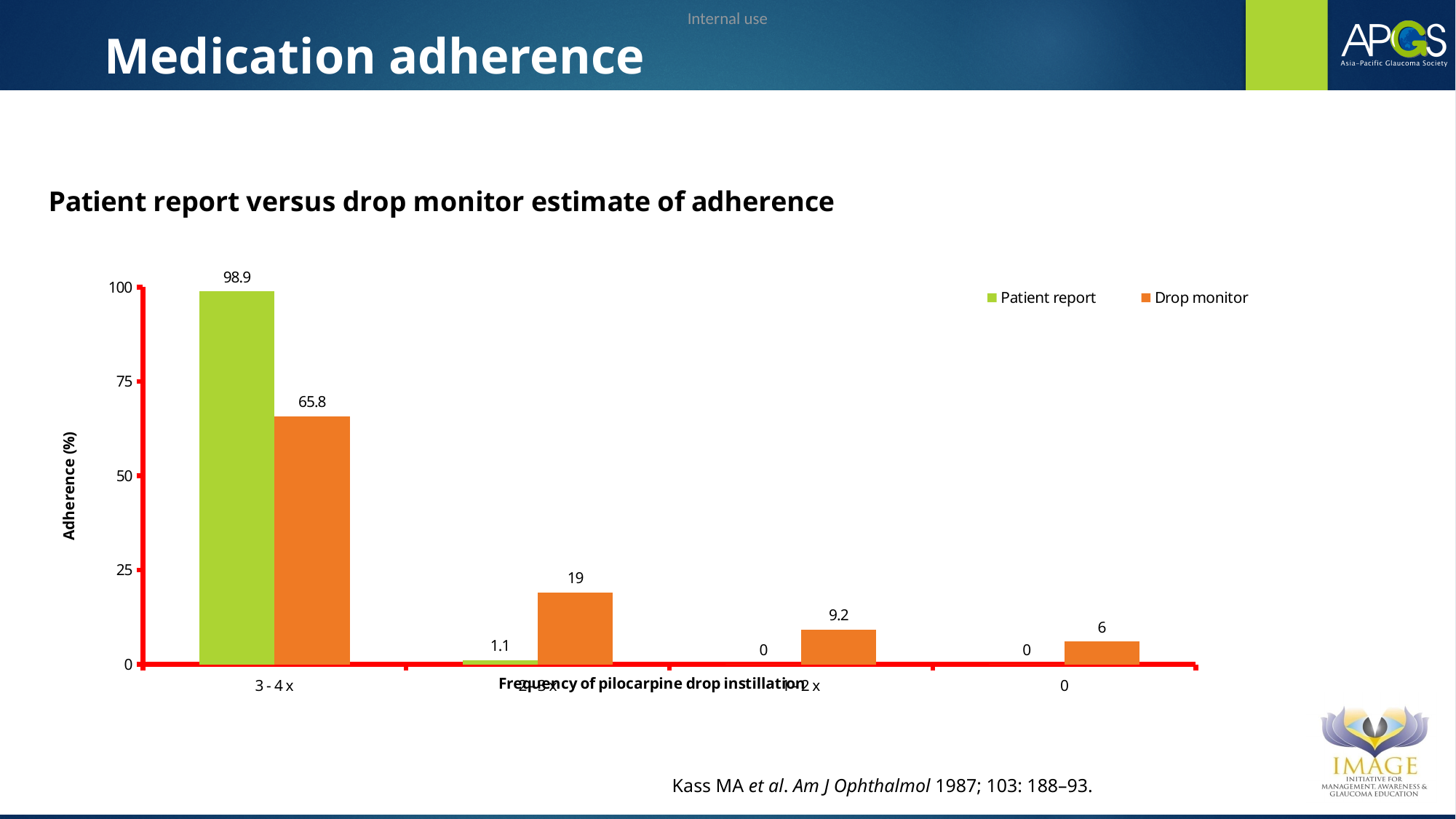
What is the Patient report value for the category labelled 0? 0 What is the Drop monitor value for the second group of bars from the left? 19 For the 3 - 4 x category, which series has the larger value, Patient report or Drop monitor? Patient report How many categories are shown along the x axis? 4 How many series does the legend list? 2 Do the Drop monitor values rise or fall from left to right along the x axis? Fall What is the Drop monitor value for the category labelled 0? 6 Which category has the highest Drop monitor value? 3 - 4 x What is the Drop monitor adherence value for the 3 - 4 x category? 65.8 What is the difference between the Patient report and Drop monitor values for the 3 - 4 x category? 33.1 What is the Patient report adherence value for the 3 - 4 x category? 98.9 What kind of chart is shown on the slide? Bar chart